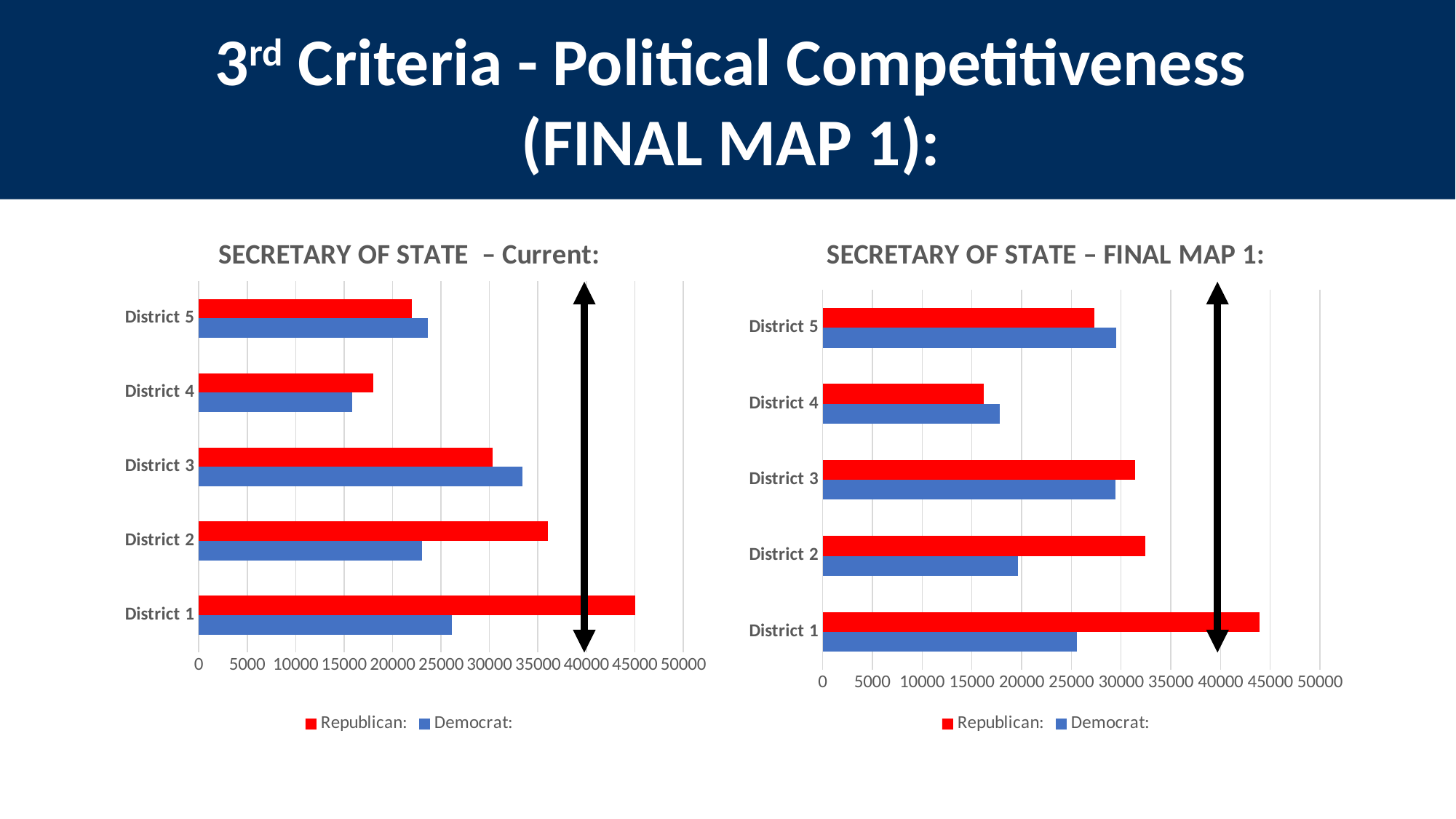
On the 'SECRETARY OF STATE – Current' chart, is the Republican value for District 1 greater or less than 40000? greater On the 'SECRETARY OF STATE – FINAL MAP 1' chart, which district has the lowest Republican value? District 4 How many districts are shown on the 'SECRETARY OF STATE – Current' chart? 5 What kind of chart is the 'SECRETARY OF STATE – Current' chart on the left? Bar chart On the 'SECRETARY OF STATE – FINAL MAP 1' chart, is the Republican or Democrat value larger for District 1? Republican On the 'SECRETARY OF STATE – FINAL MAP 1' chart, which district has the highest Republican value? District 1 What colour represents the Democrat series in the legend of the charts? Blue On the 'SECRETARY OF STATE – Current' chart, which district has the lowest Democrat value? District 4 On the 'SECRETARY OF STATE – Current' chart, is the Republican or Democrat value larger for District 2? Republican On the 'SECRETARY OF STATE – Current' chart, which district has the highest Republican value? District 1 How many series does the legend of the 'SECRETARY OF STATE – FINAL MAP 1' chart list? 2 On the 'SECRETARY OF STATE – FINAL MAP 1' chart, is the Democrat value for District 2 greater or less than 25000? less